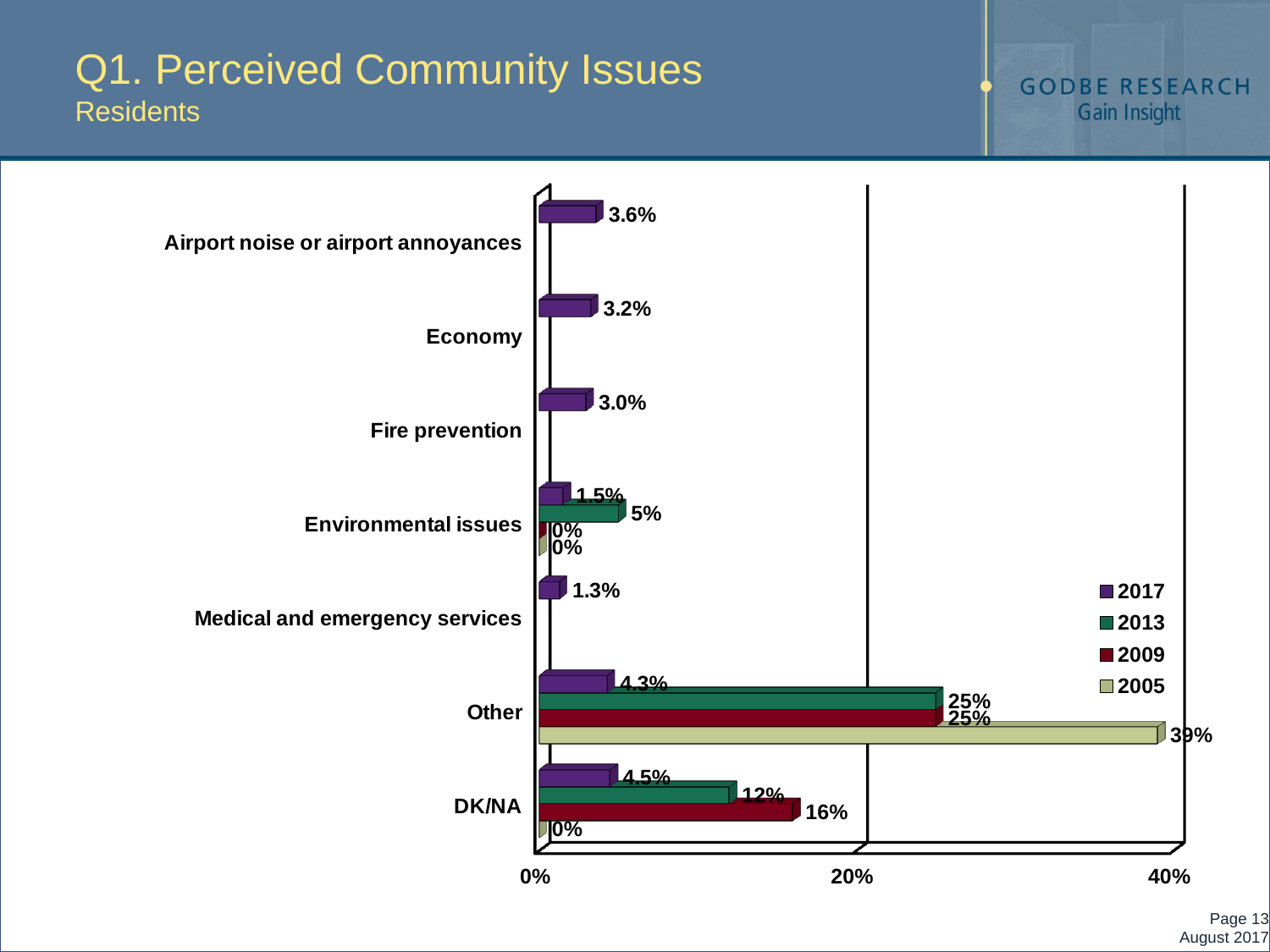
How many categories are shown on the chart? 7 What is the 2013 value for Environmental issues? 5% What kind of chart is shown on the slide? Bar chart Which is larger for Other: the 2005 value or the 2013 value? 2005 What is the 2009 value for DK/NA? 16% Which category has the lowest 2017 value? Medical and emergency services What is the 2017 value for Airport noise or airport annoyances? 3.6% What is the difference between the 2009 and 2013 values for DK/NA? 4% How many series does the legend list? 4 Which category has the highest 2017 value? DK/NA What is the 2005 value for Other? 39% Is the 2005 value for Other greater or less than 20%? greater